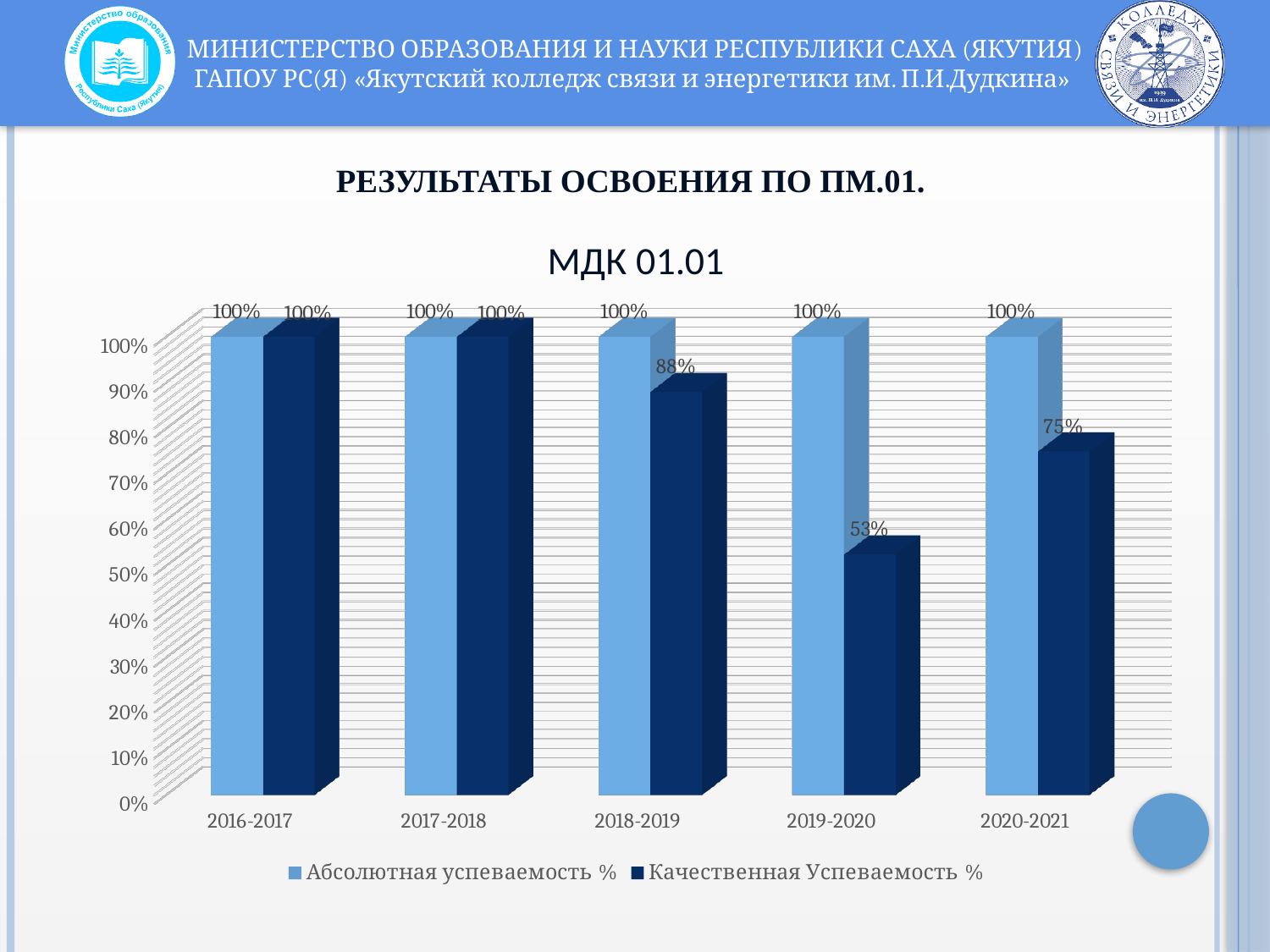
How many series does the legend list? 2 What is the difference between Абсолютная успеваемость % and Качественная Успеваемость % for 2019-2020? 47% What is the value of Качественная Успеваемость % for 2019-2020? 53% What is the value of Качественная Успеваемость % for 2018-2019? 88% What is the value of Качественная Успеваемость % for 2020-2021? 75% What is the value of Абсолютная успеваемость % for 2017-2018? 100% Which year has the lowest Качественная Успеваемость %? 2019-2020 What kind of chart is shown on the slide? Bar chart What is the difference between Качественная Успеваемость % for 2018-2019 and 2020-2021? 13% How many year categories are shown on the x axis? 5 What is the title of the chart? МДК 01.01 Which is larger, Качественная Успеваемость % for 2018-2019 or for 2020-2021? 2018-2019